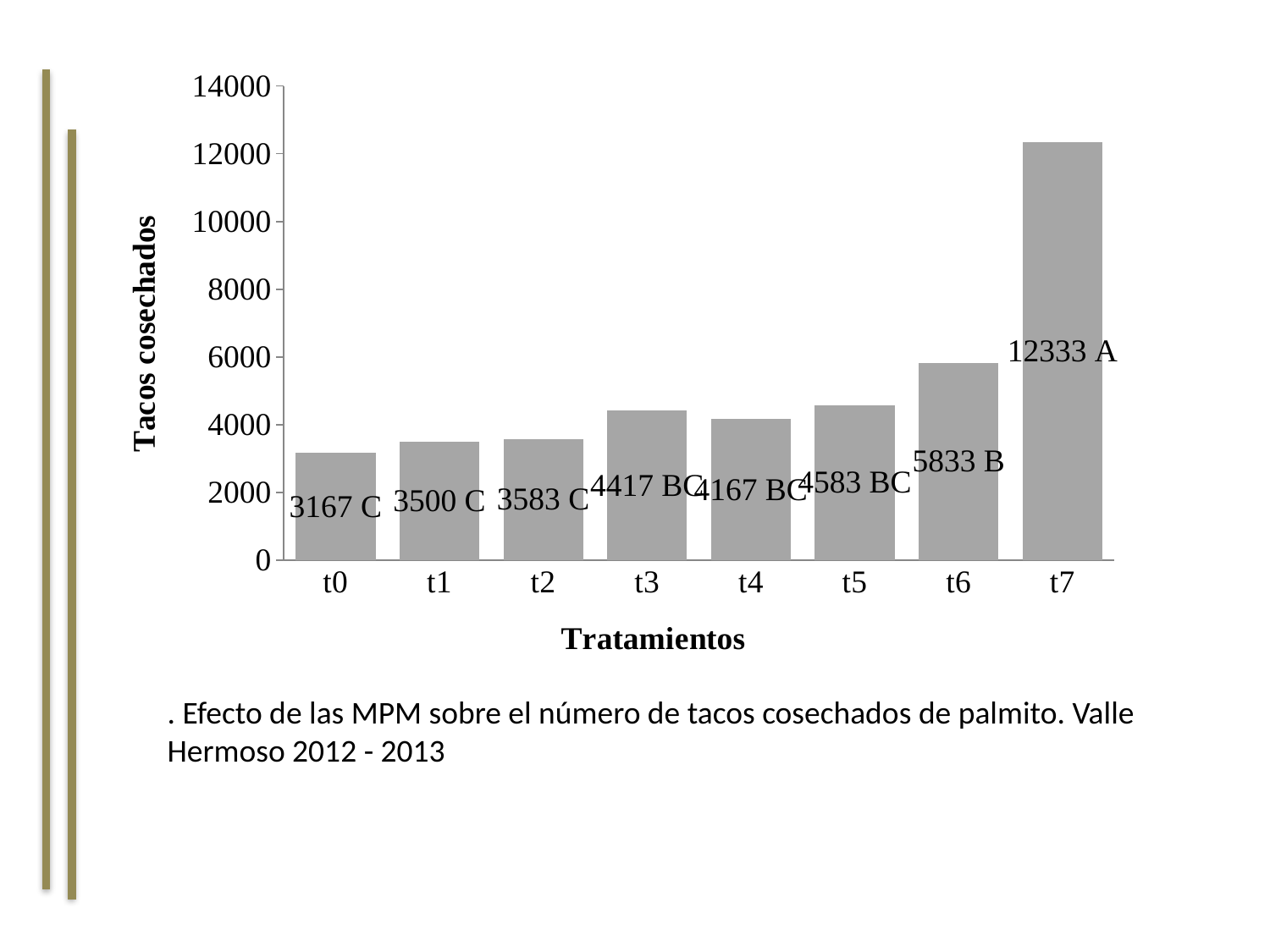
What is the difference in tacos cosechados between t1 and t0? 333 What is the data label shown for treatment t0? 3167 C Which treatment has the lowest number of tacos cosechados? t0 What is the data label shown for treatment t3? 4417 BC How many treatments are shown on the x axis? 8 Which treatment has more tacos cosechados, t3 or t4? t3 Which treatment has the highest number of tacos cosechados? t7 Is the value for t5 greater or less than 4000? greater What is the data label shown for treatment t6? 5833 B What is the data label shown for treatment t7? 12333 A What is the difference in tacos cosechados between t7 and t6? 6500 What kind of chart is shown on the slide? bar chart